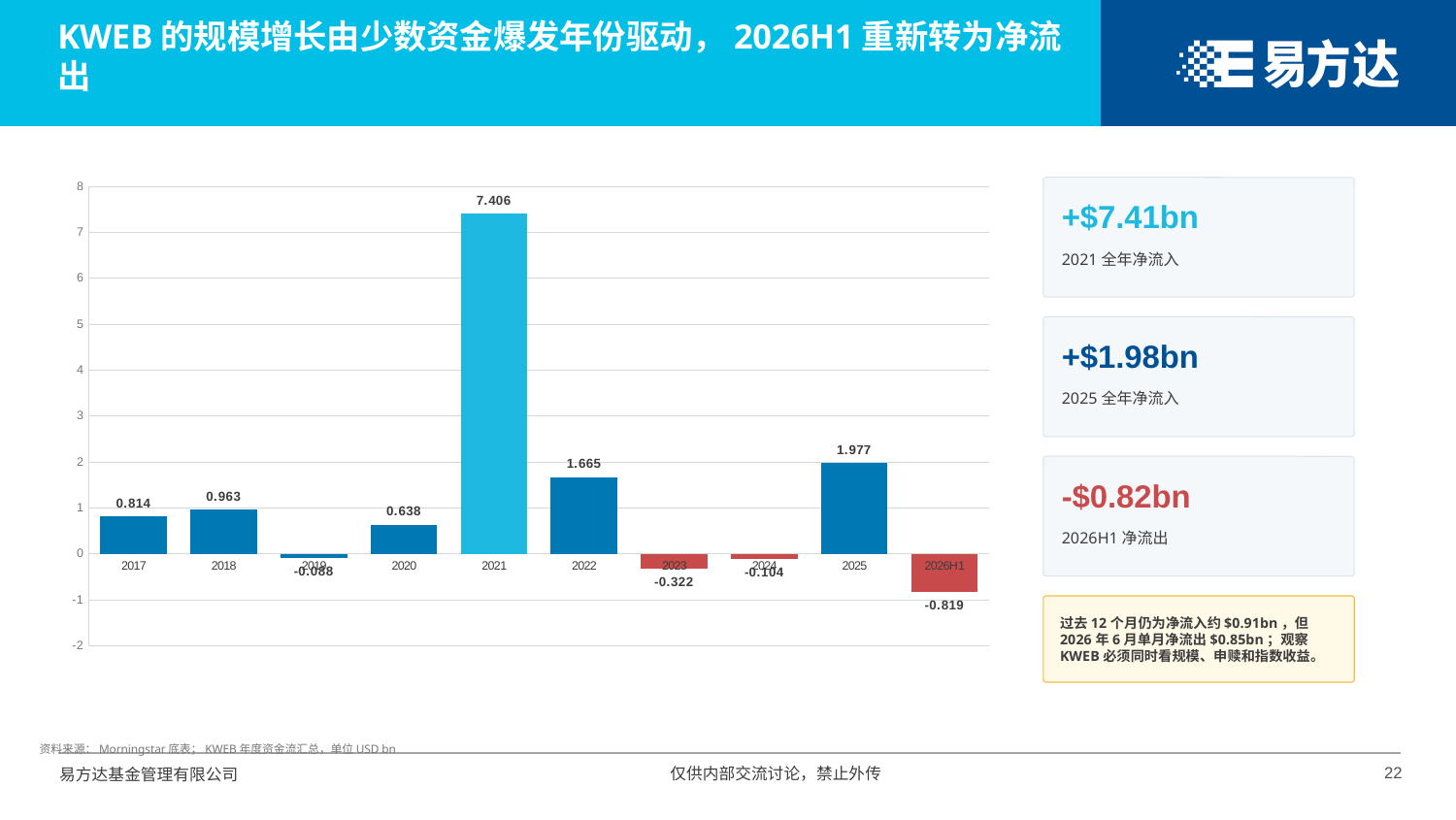
What is the value for 2026H1? -0.819 What is the difference between the values for 2025 and 2022? 0.312 What is the value for 2021? 7.406 Which year has the highest value? 2021 What is the value for 2018? 0.963 Is the value for 2021 greater or less than 7? greater Which category has the lowest value? 2026H1 Which is larger, the value for 2017 or the value for 2020? 2017 How many categories are shown on the x axis? 10 What is the value for 2023? -0.322 What kind of chart is shown on the slide? bar chart How many categories have negative values? 4